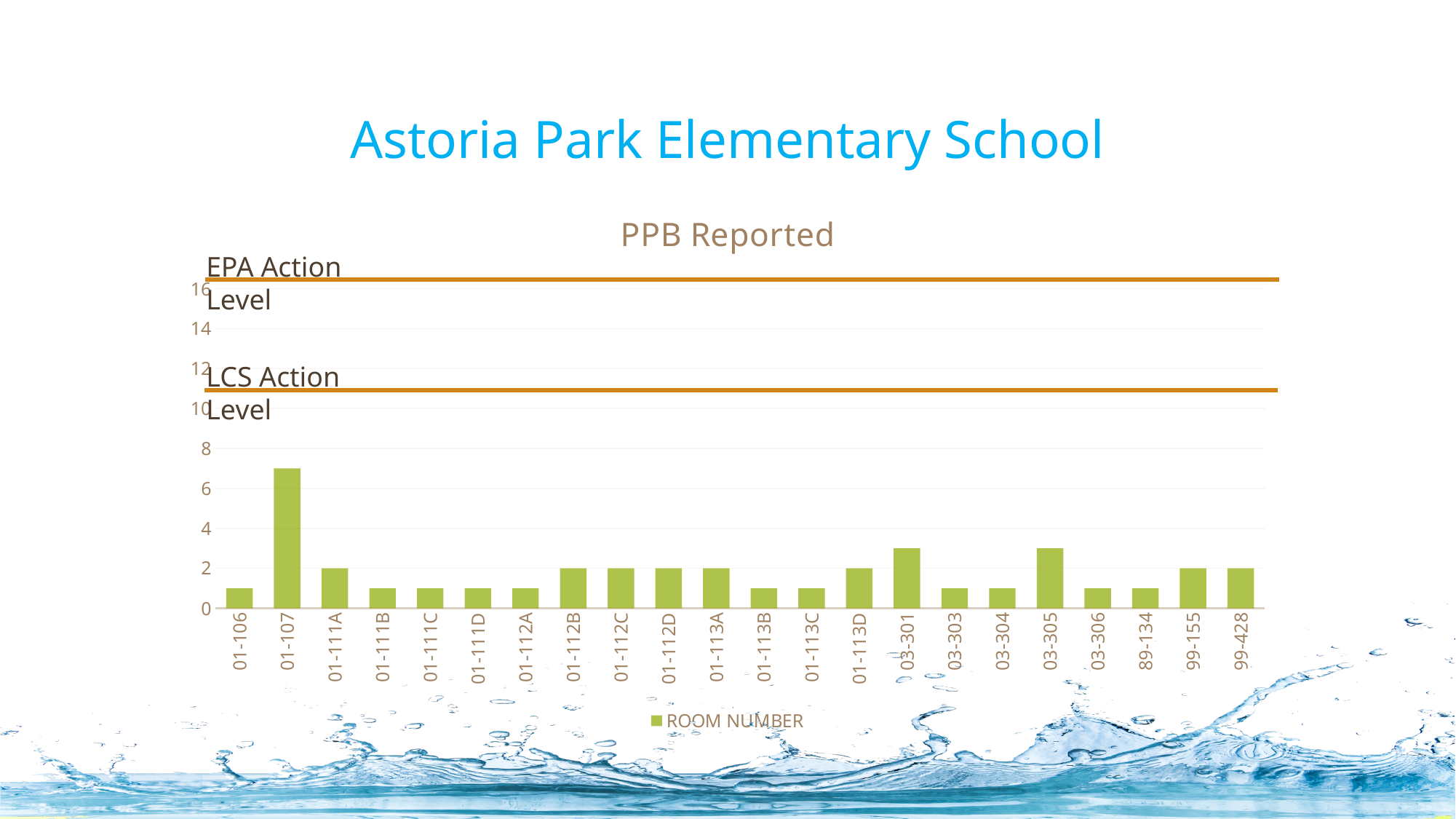
Is the value for 01-107 greater or less than 6? greater Which has a higher PPB reported value, 01-107 or 03-305? 01-107 Which room number has the highest PPB reported value? 01-107 What is the PPB reported value for 01-111A? 2 What type of chart is shown on the slide? bar chart Is the value for 03-301 greater or less than 2? greater What is the PPB reported value for 99-428? 2 How many room numbers are shown on the x axis? 22 How many series does the legend list? 1 Is the value for 01-107 greater or less than 8? less What is the title of the chart? PPB Reported